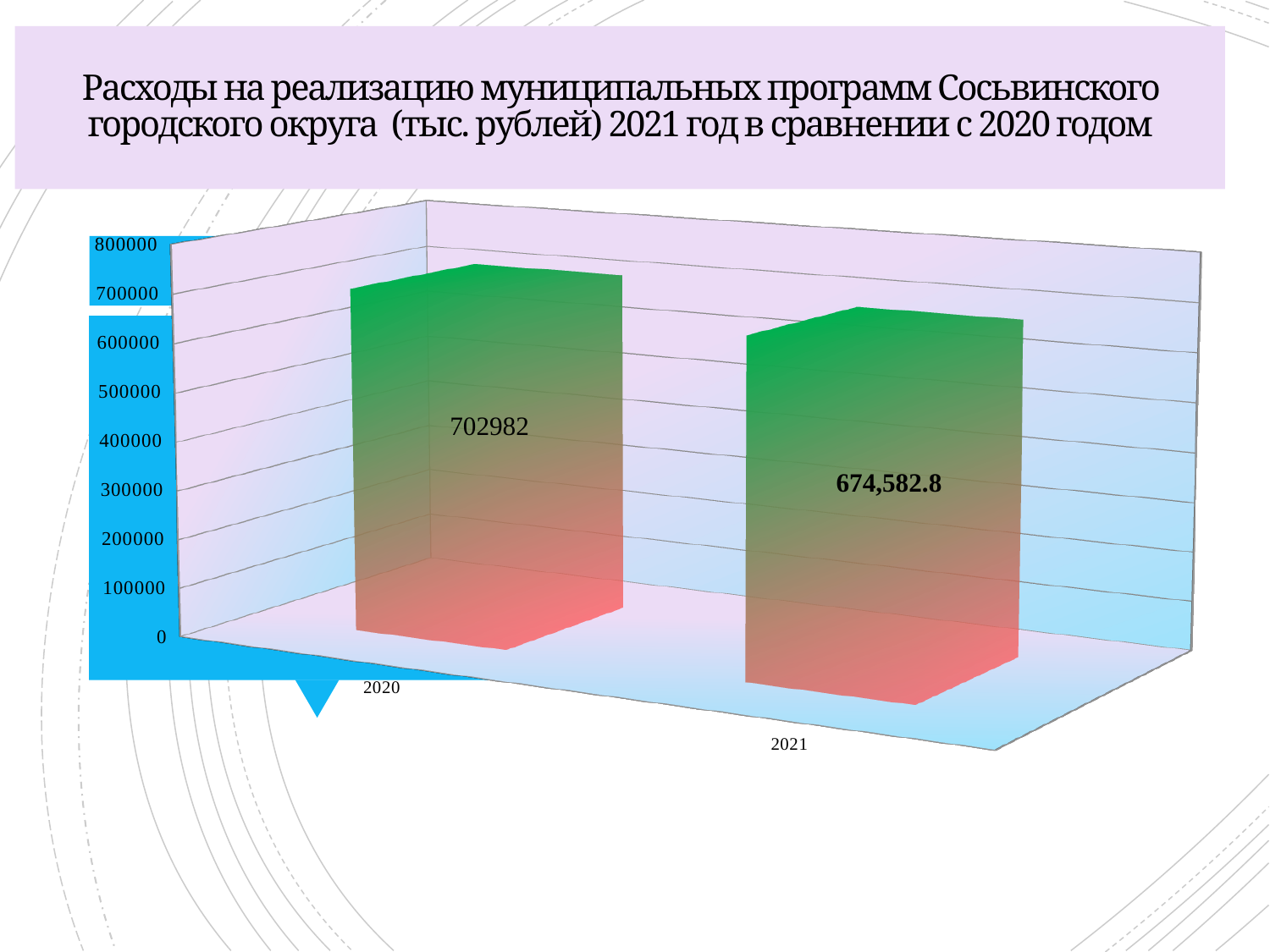
Is the value for 2021 larger or smaller than the value for 2020? smaller What kind of chart is shown on the slide? bar chart Is the value for 2020 greater or less than 800000? less What is the highest tick value shown on the vertical axis? 800000 Which year has the higher value? 2020 Which year has the lower value? 2021 What is the value shown for 2020? 702982 How many years (categories) are plotted on the chart? 2 What is the value shown for 2021? 674,582.8 Do the values rise or fall from 2020 to 2021? fall What is the difference between the 2020 value and the 2021 value? 28399.2 Is the value for 2021 greater or less than 600000? greater